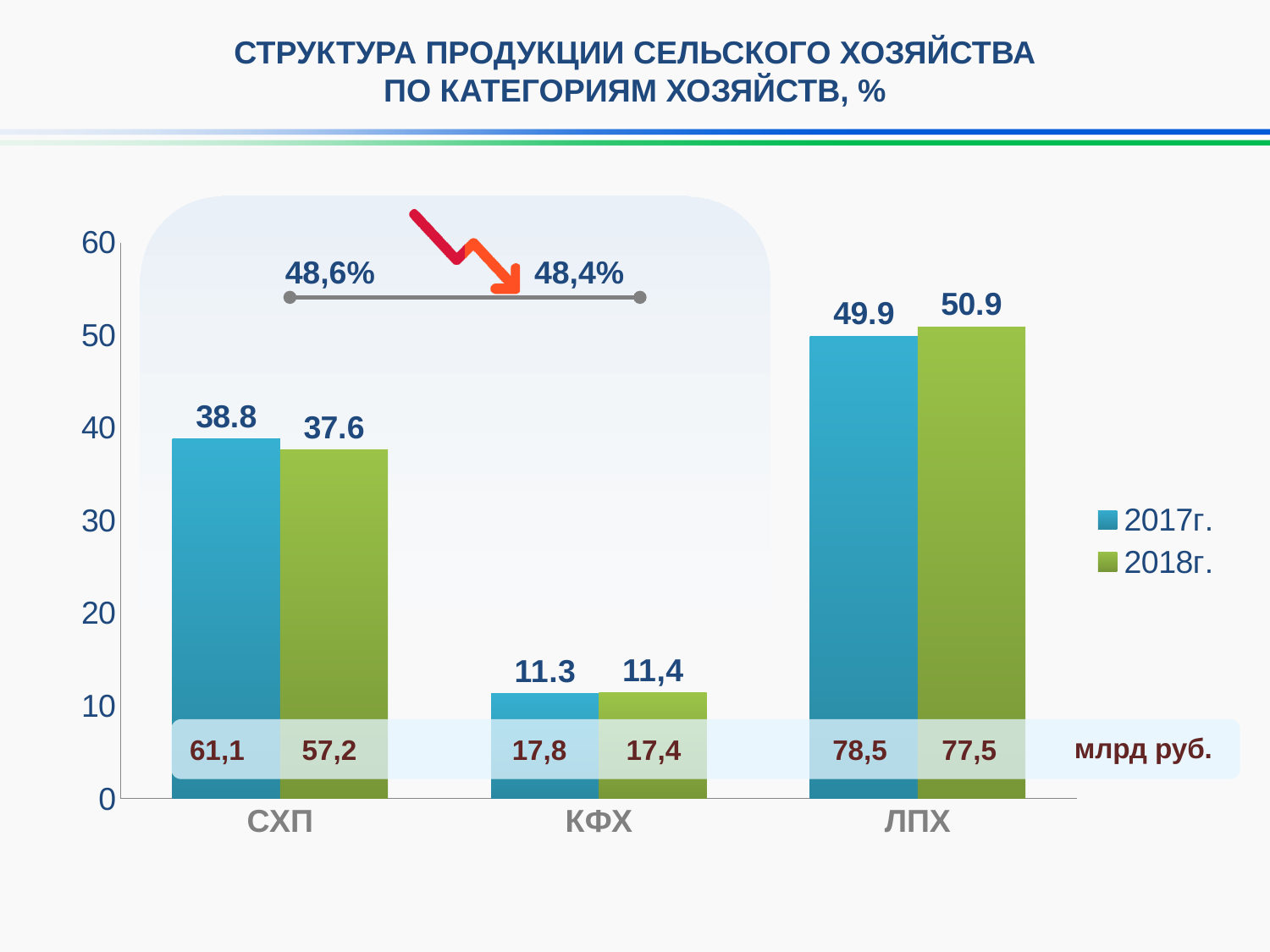
What is the difference between the 2017г. and 2018г. values for СХП? 1.2 What is the value for КФХ in the 2017г. series? 11.3 What is the difference between the ЛПХ and СХП values in the 2017г. series? 11.1 How many categories are shown on the x axis? 3 What is the value for СХП in the 2017г. series? 38.8 Is the 2018г. value for СХП greater or less than 40? less What is the value for ЛПХ in the 2018г. series? 50.9 What kind of chart is shown on the slide? bar chart Which category has the lowest value in the 2017г. series? КФХ Which is larger for ЛПХ: the 2017г. value or the 2018г. value? 2018г. How many series does the legend list? 2 Which category has the highest value in the 2018г. series? ЛПХ